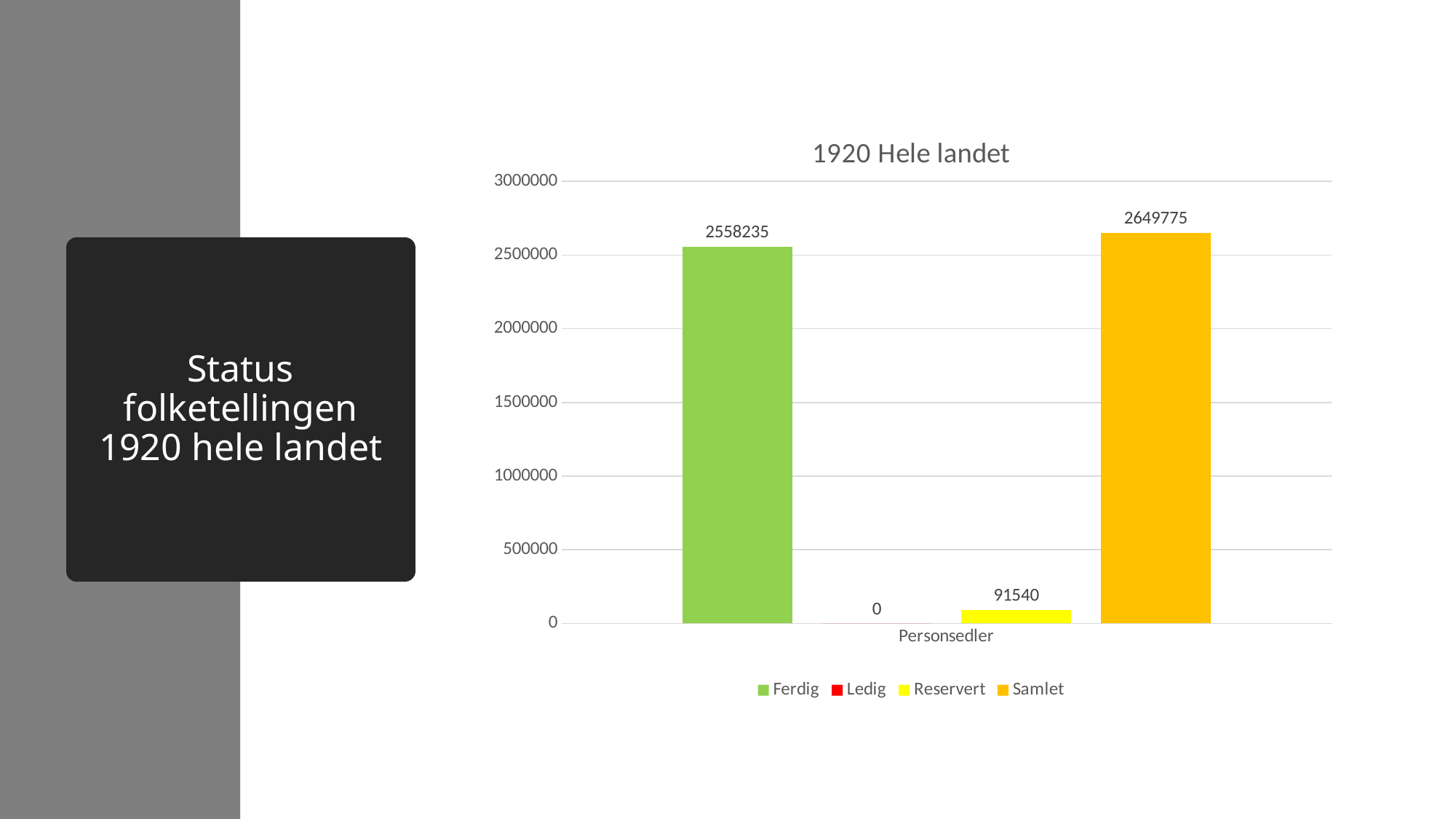
What is the value for Reservert in the chart? 91540 What is the value for Samlet in the chart? 2649775 Is the value for Ferdig greater or less than 2500000? greater What kind of chart is shown on the slide? Bar chart Which series has the highest value in the chart? Samlet What is the difference between the Samlet and Ferdig values? 91540 What is the value for Ledig in the chart? 0 How many series does the legend list? 4 What is the value for Ferdig in the chart? 2558235 What is the title of the chart? 1920 Hele landet Which series has the lowest value in the chart? Ledig Which is larger, the value for Ferdig or the value for Reservert? Ferdig